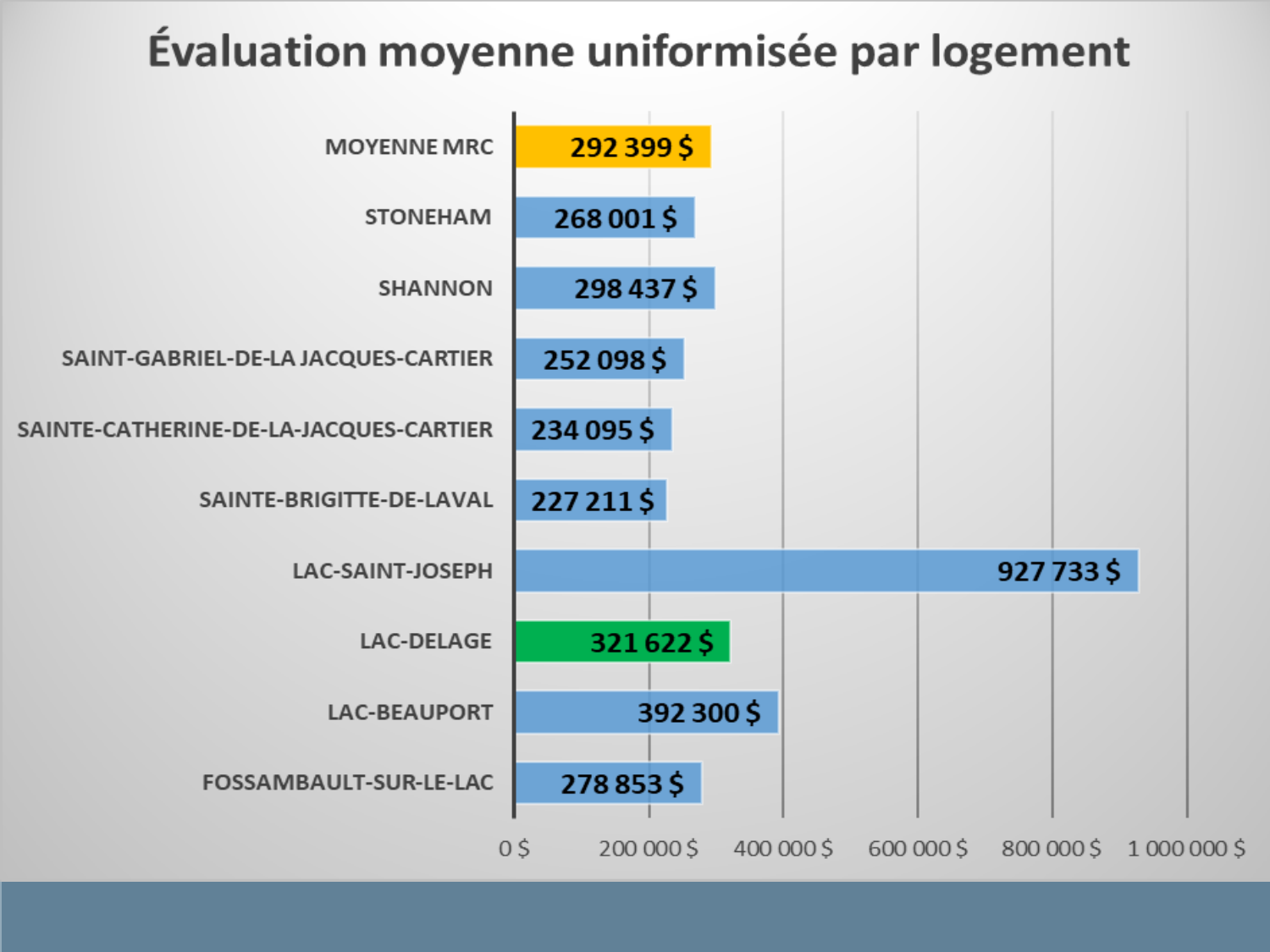
How many categories are shown in the chart? 10 What is the difference between the values for LAC-BEAUPORT and LAC-DELAGE? 70 678 $ What is the value for MOYENNE MRC? 292 399 $ Which is larger, the value for SHANNON or the value for STONEHAM? SHANNON Which category has the lowest value? SAINTE-BRIGITTE-DE-LAVAL What is the value for LAC-SAINT-JOSEPH? 927 733 $ What is the difference between the values for LAC-SAINT-JOSEPH and MOYENNE MRC? 635 334 $ What colour is the bar for LAC-DELAGE? green What is the value for SAINTE-CATHERINE-DE-LA-JACQUES-CARTIER? 234 095 $ Is the value for LAC-SAINT-JOSEPH greater or less than 800 000 $? greater Which category has the highest value? LAC-SAINT-JOSEPH What kind of chart is shown on the slide? bar chart